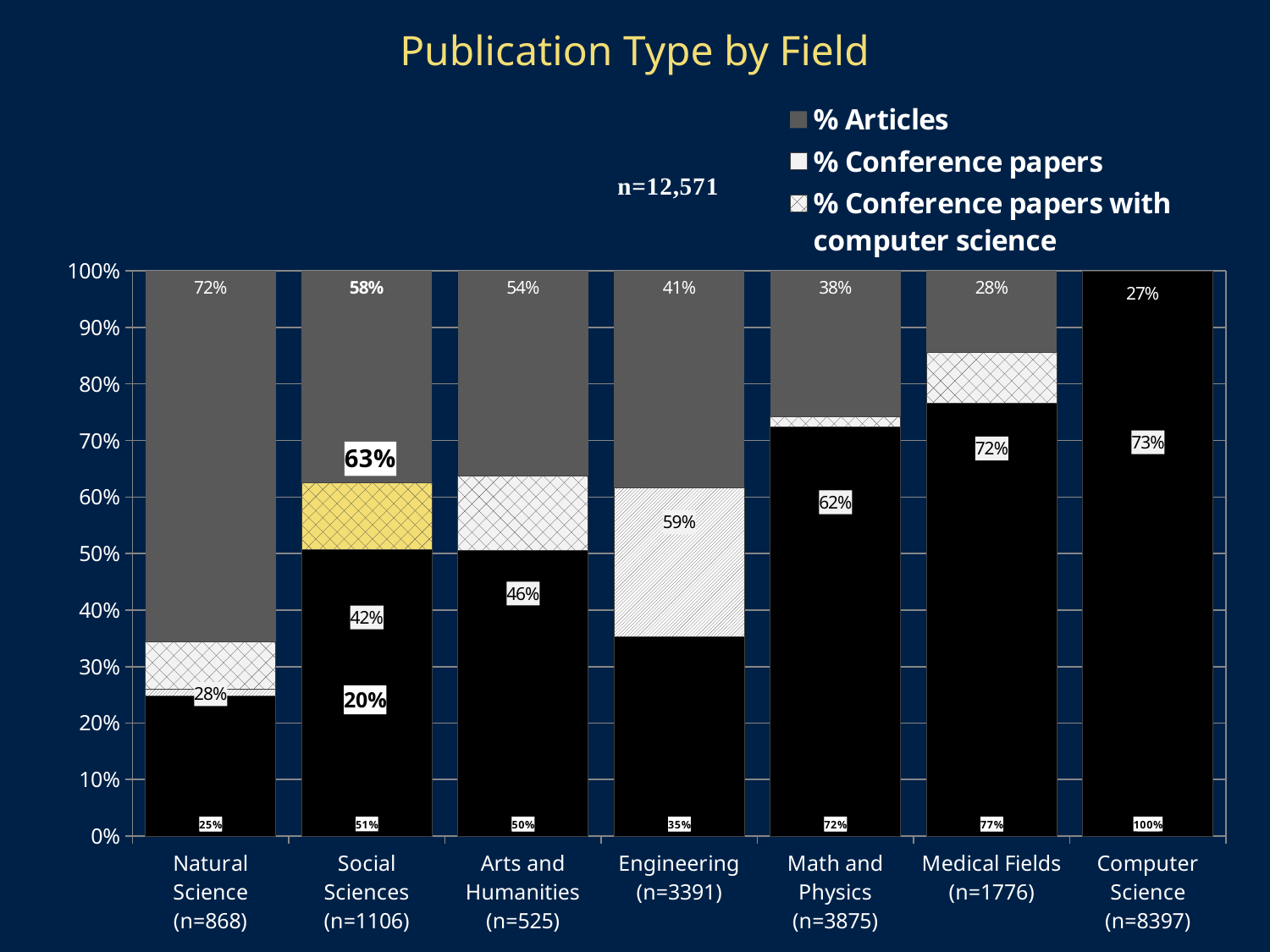
What total sample size (n) is printed on the slide? n=12,571 What is the % Articles value for Natural Science? 72% Which has a higher % Articles, Math and Physics or Medical Fields? Math and Physics How many series does the legend list? 3 Moving from left to right across the fields, does the % Articles value rise or fall? Fall How many fields (categories) are shown along the x axis? 7 What is the % Articles value for Engineering? 41% What is the difference in % Articles between Natural Science and Social Sciences? 14 percentage points Which field has the lowest % Articles? Computer Science Which field has the highest % Articles? Natural Science Is the % Articles value for Arts and Humanities greater or less than 50%? greater What kind of chart is shown on the slide? Stacked bar chart